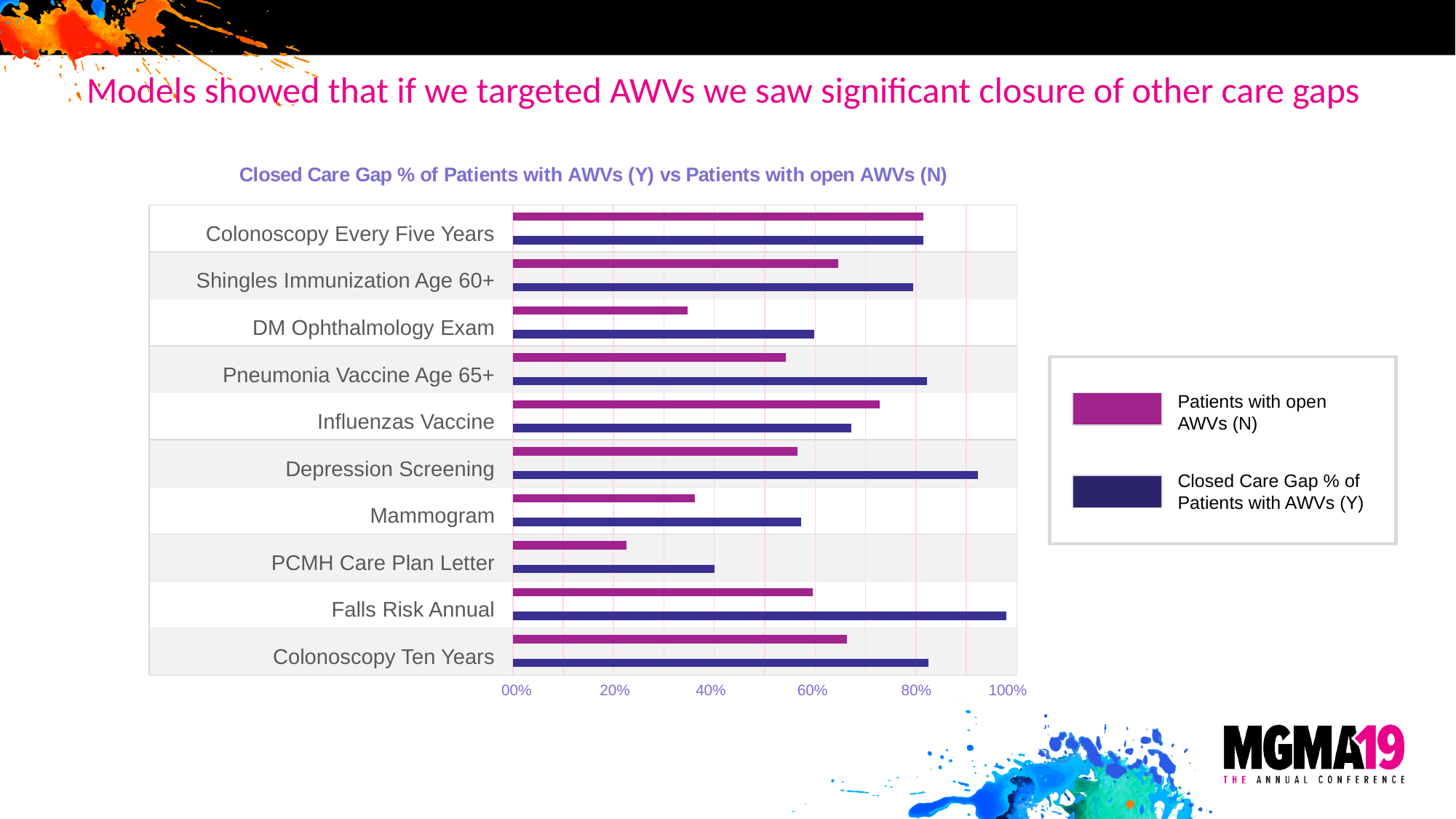
Is the value for Patients with open AWVs (N) for DM Ophthalmology Exam greater or less than 40%? less Which category has the lowest Closed Care Gap % of Patients with AWVs (Y)? PCMH Care Plan Letter How many series does the legend list? 2 Which category has the highest Closed Care Gap % of Patients with AWVs (Y)? Falls Risk Annual Is the Closed Care Gap % of Patients with AWVs (Y) for Depression Screening greater or less than 80%? greater For Depression Screening, which series has the larger value: Patients with open AWVs (N) or Closed Care Gap % of Patients with AWVs (Y)? Closed Care Gap % of Patients with AWVs (Y) Which category has the lowest value for Patients with open AWVs (N)? PCMH Care Plan Letter Is the value for Patients with open AWVs (N) for PCMH Care Plan Letter greater or less than 40%? less What is the title of the chart? Closed Care Gap % of Patients with AWVs (Y) vs Patients with open AWVs (N) For Influenzas Vaccine, which series has the larger value: Patients with open AWVs (N) or Closed Care Gap % of Patients with AWVs (Y)? Patients with open AWVs (N) What kind of chart is shown on the slide? bar chart How many care gap categories are listed on the chart? 10